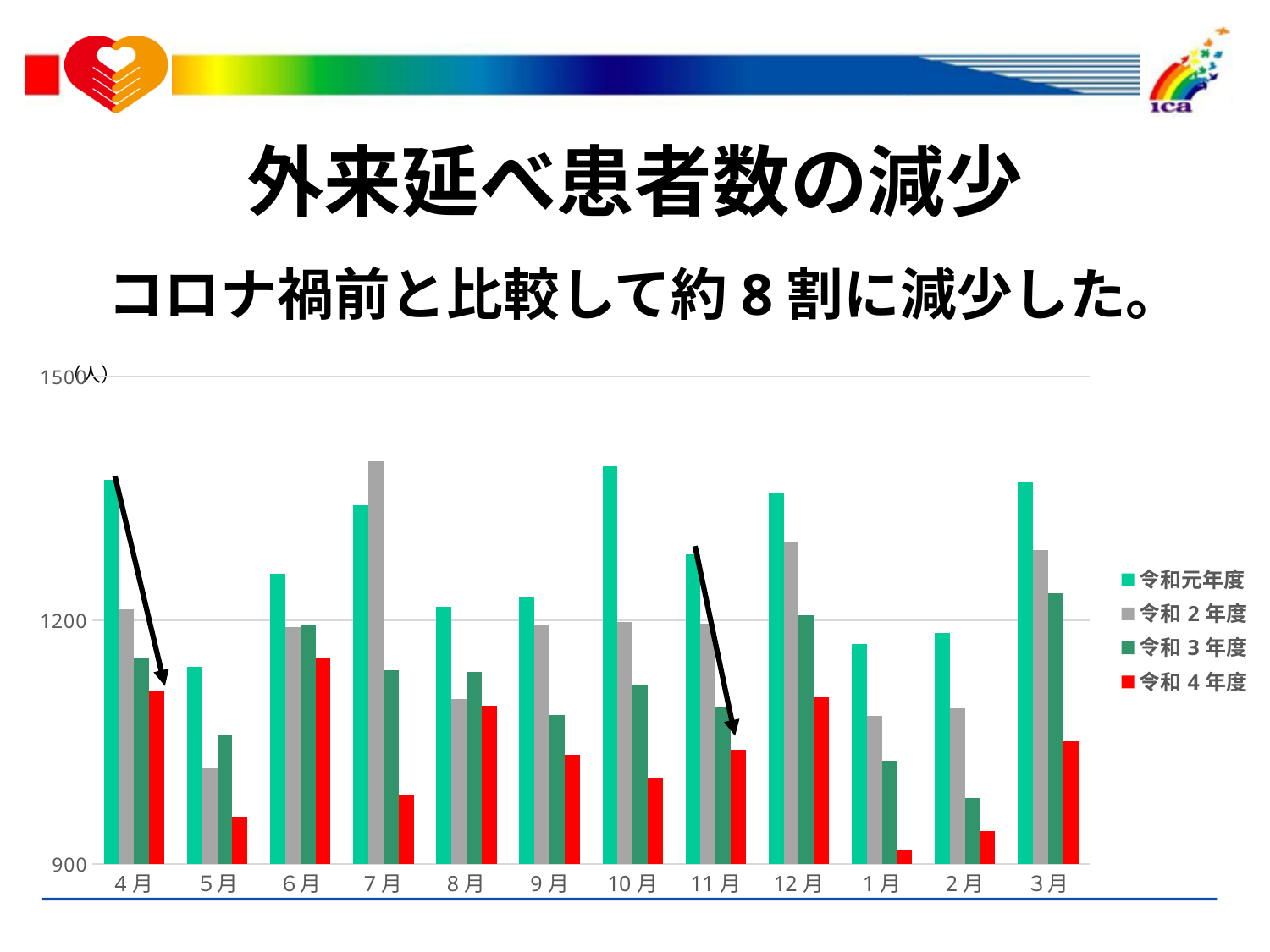
Is the value for 令和4年度 in 7月 greater or less than 1200? less Which month has the lowest value for 令和4年度? 1月 How many months are shown on the x axis of the chart? 12 Is the value for 令和元年度 in 4月 greater or less than 1200? greater In 7月, which is larger: the value for 令和元年度 or the value for 令和2年度? 令和2年度 What is the title of the slide containing the chart? 外来延べ患者数の減少 Is the value for 令和3年度 in 3月 greater or less than 1200? greater Which series is shown in red in the chart's legend? 令和4年度 In 12月, which is larger: the value for 令和3年度 or the value for 令和4年度? 令和3年度 In 4月, which is larger: the value for 令和元年度 or the value for 令和4年度? 令和元年度 How many series does the chart's legend list? 4 What kind of chart is shown on the slide? bar chart